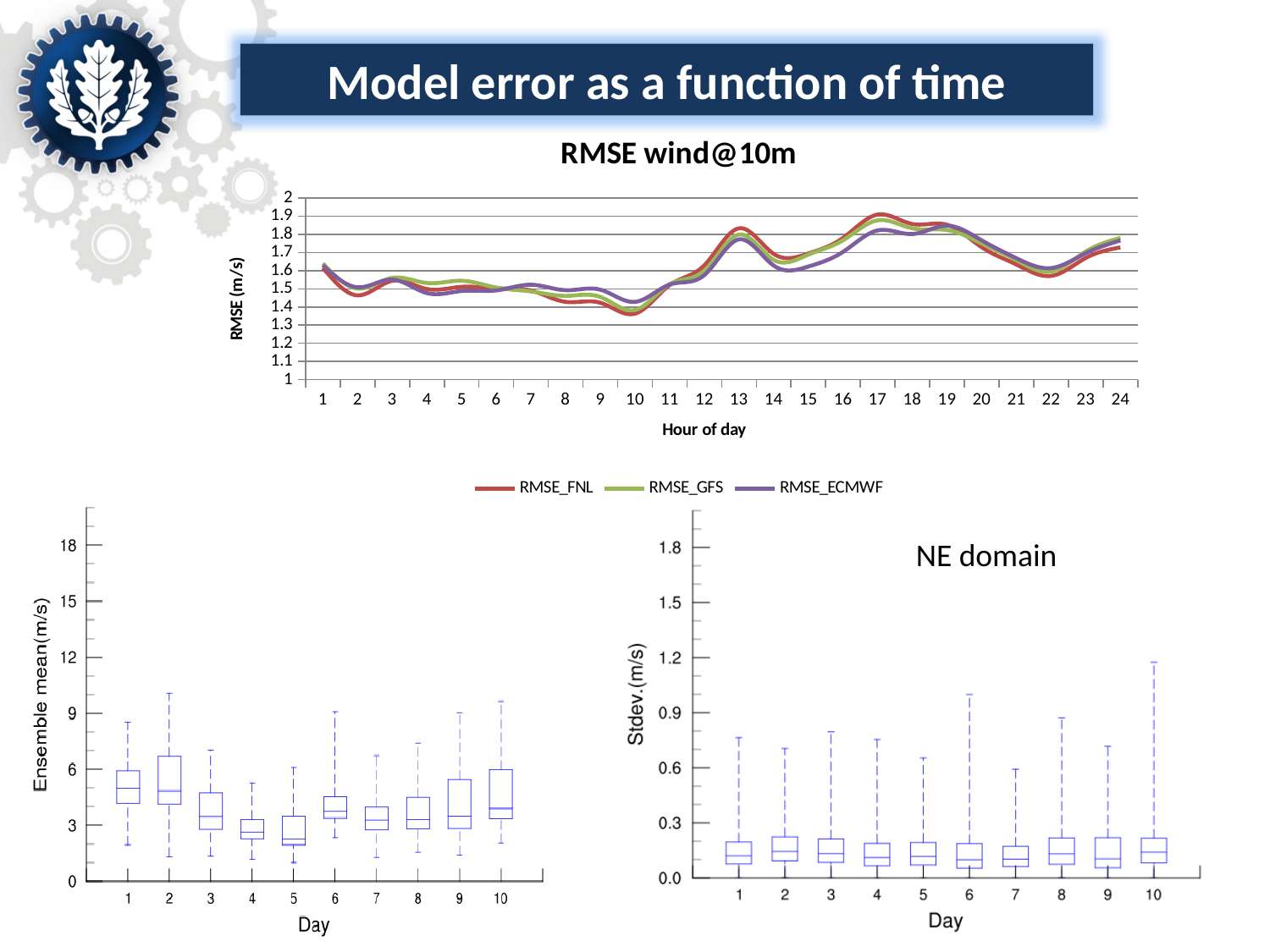
How many series does the legend of the 'RMSE wind@10m' chart list? 3 In the 'RMSE wind@10m' chart, is the RMSE_FNL value at hour 17 greater or less than 1.8? greater In the 'RMSE wind@10m' chart, at which hour of day does the RMSE_FNL series reach its lowest value? 10 What is the label of the y axis on the 'RMSE wind@10m' chart? RMSE (m/s) In the 'RMSE wind@10m' chart, do the RMSE values rise or fall between hour 10 and hour 13? rise In the 'RMSE wind@10m' chart, is the RMSE_ECMWF value at hour 14 greater or less than 1.7? less In the 'RMSE wind@10m' chart, is the RMSE_GFS value at hour 10 greater or less than 1.4? less In the 'RMSE wind@10m' chart, which series is higher at hour 14, RMSE_FNL or RMSE_ECMWF? RMSE_FNL In the 'RMSE wind@10m' chart, at which hour of day does the RMSE_FNL series reach its highest value? 17 What kind of chart is the 'RMSE wind@10m' chart at the top of the slide? line chart How many hours of the day are plotted along the x axis of the 'RMSE wind@10m' chart? 24 How many days are shown on the x axis of the bottom-left 'Ensemble mean(m/s)' box plot? 10